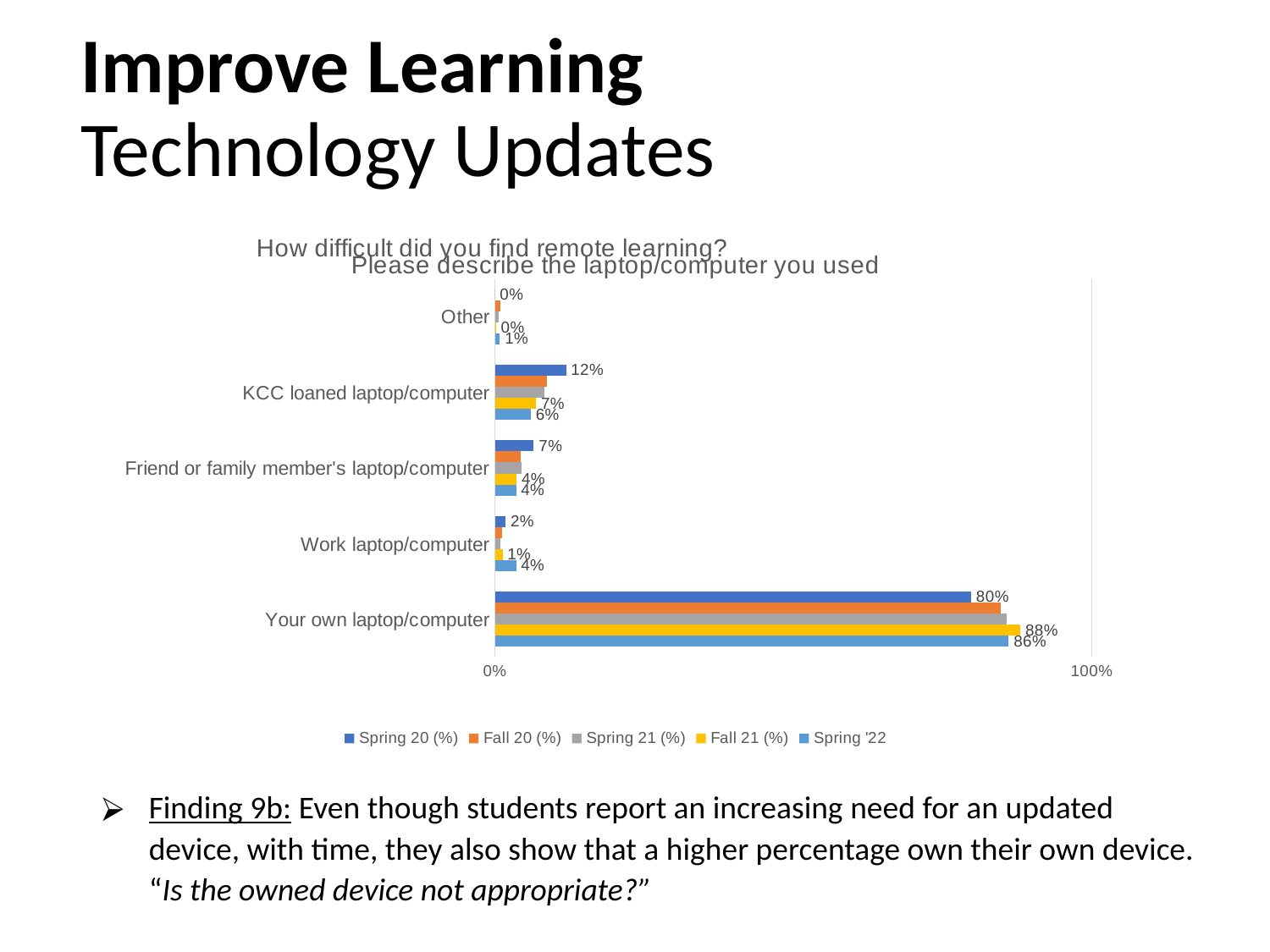
How many series does the legend list? 5 How many categories are shown on the chart? 5 What is the Spring '22 value for 'Your own laptop/computer'? 86% What is the Spring '22 value for 'Work laptop/computer'? 4% What is the difference between the Fall 21 (%) and Spring 20 (%) values for 'Your own laptop/computer'? 8% Which category has the highest value for the Spring 20 (%) series? Your own laptop/computer What is the Fall 21 (%) value for 'Your own laptop/computer'? 88% What is the last series listed in the legend? Spring '22 What kind of chart is shown on the slide? bar chart What is the Spring 20 (%) value for 'Your own laptop/computer'? 80% What is the Spring 20 (%) value for 'KCC loaned laptop/computer'? 12% Which is larger for 'KCC loaned laptop/computer': the Spring 20 (%) value or the Spring '22 value? Spring 20 (%)